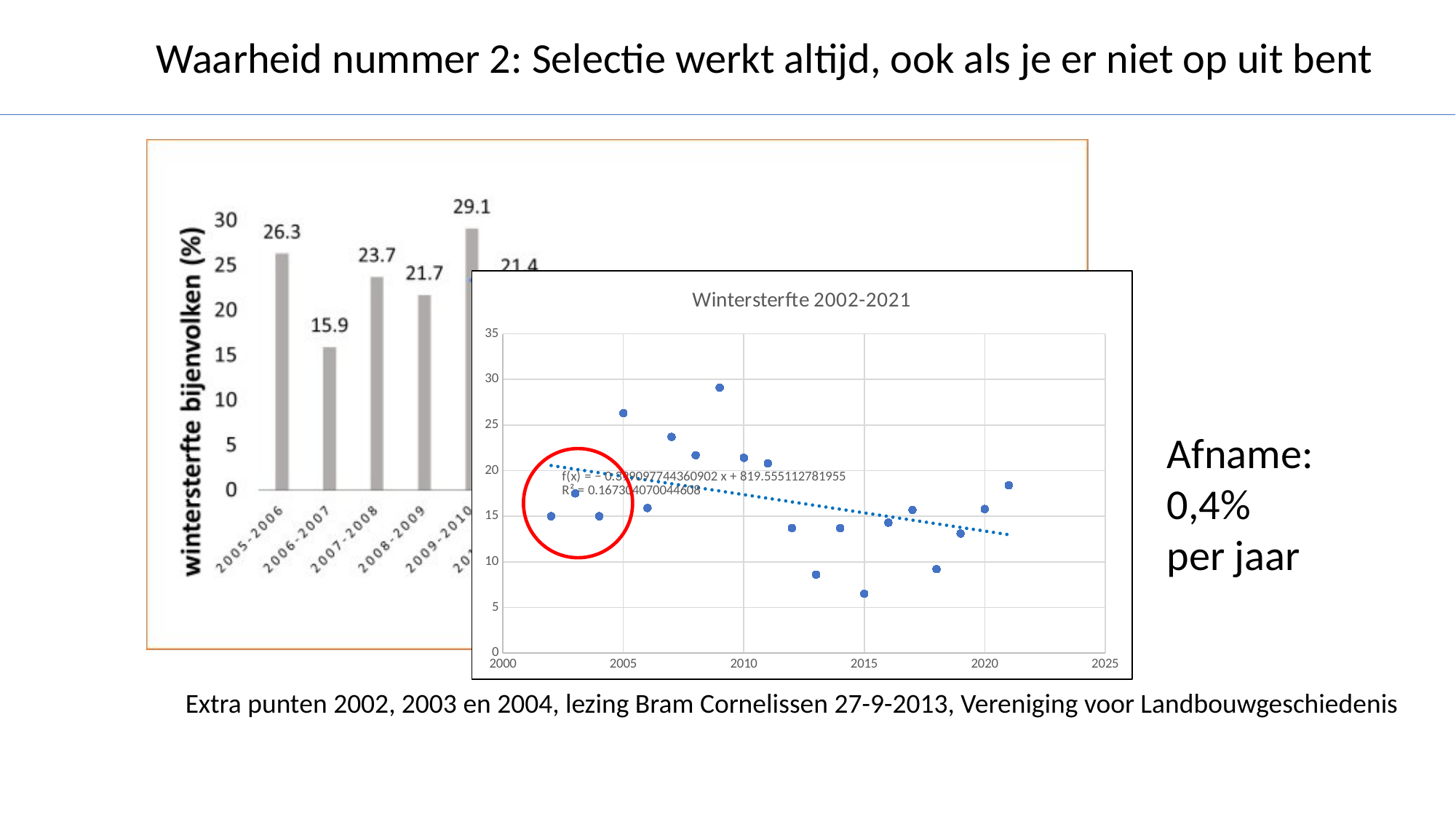
In the bar chart on the left, what is the difference between the values for 2005-2006 and 2006-2007? 10.4 In the bar chart on the left, what is the value for 2006-2007? 15.9 What kind of chart is the 'Wintersterfte 2002-2021' chart? scatter chart In the bar chart on the left, what is the winter mortality value for 2005-2006? 26.3 What is the title of the chart on the right? Wintersterfte 2002-2021 In the bar chart on the left, which is larger: the value for 2007-2008 or for 2008-2009? 2007-2008 In the bar chart on the left, what is the value for 2009-2010? 29.1 In the 'Wintersterfte 2002-2021' chart, how many data points are plotted? 20 In the bar chart on the left, which of the readable seasons has the lowest winter mortality? 2006-2007 In the bar chart on the left, what is the y-axis label? wintersterfte bijenvolken (%) In the 'Wintersterfte 2002-2021' chart, does the trendline rise or fall from 2002 to 2021? fall In the 'Wintersterfte 2002-2021' chart, is the value for 2015 greater or less than 10? less